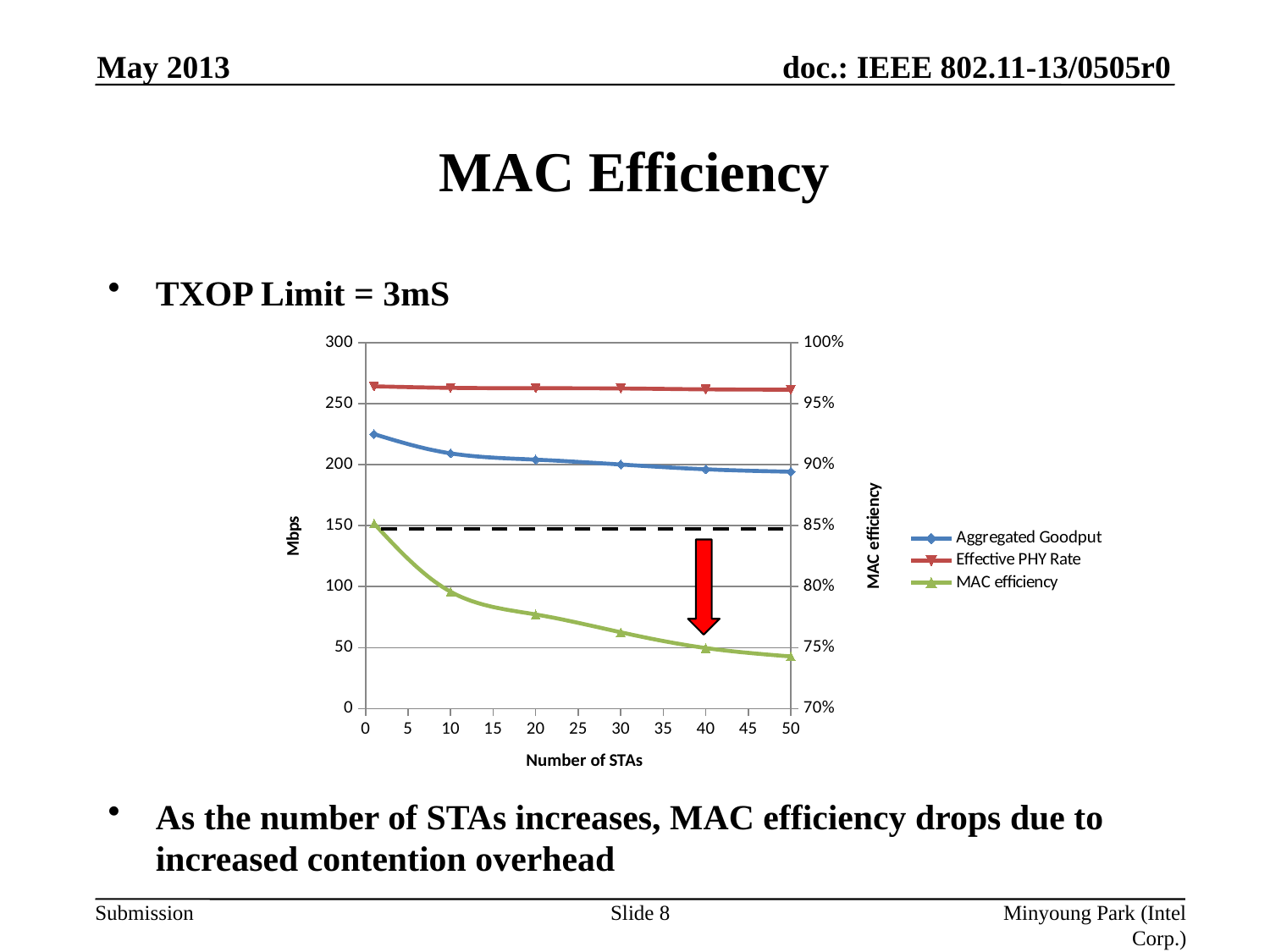
What kind of chart is shown on the slide? line chart What are the three series listed in the legend? Aggregated Goodput, Effective PHY Rate, MAC efficiency What is the label of the x axis? Number of STAs Which series has higher values on the Mbps axis, Effective PHY Rate or Aggregated Goodput? Effective PHY Rate How many series does the legend list? 3 Is the MAC efficiency at 20 STAs greater or less than 80%? less Is the Aggregated Goodput value at 50 STAs greater or less than 200 Mbps? less Is the Aggregated Goodput value at 1 STA greater or less than 200 Mbps? greater Does the MAC efficiency series rise or fall as the number of STAs increases? fall Does the Aggregated Goodput series rise or fall as the number of STAs increases? fall How many data points are plotted for the MAC efficiency series? 6